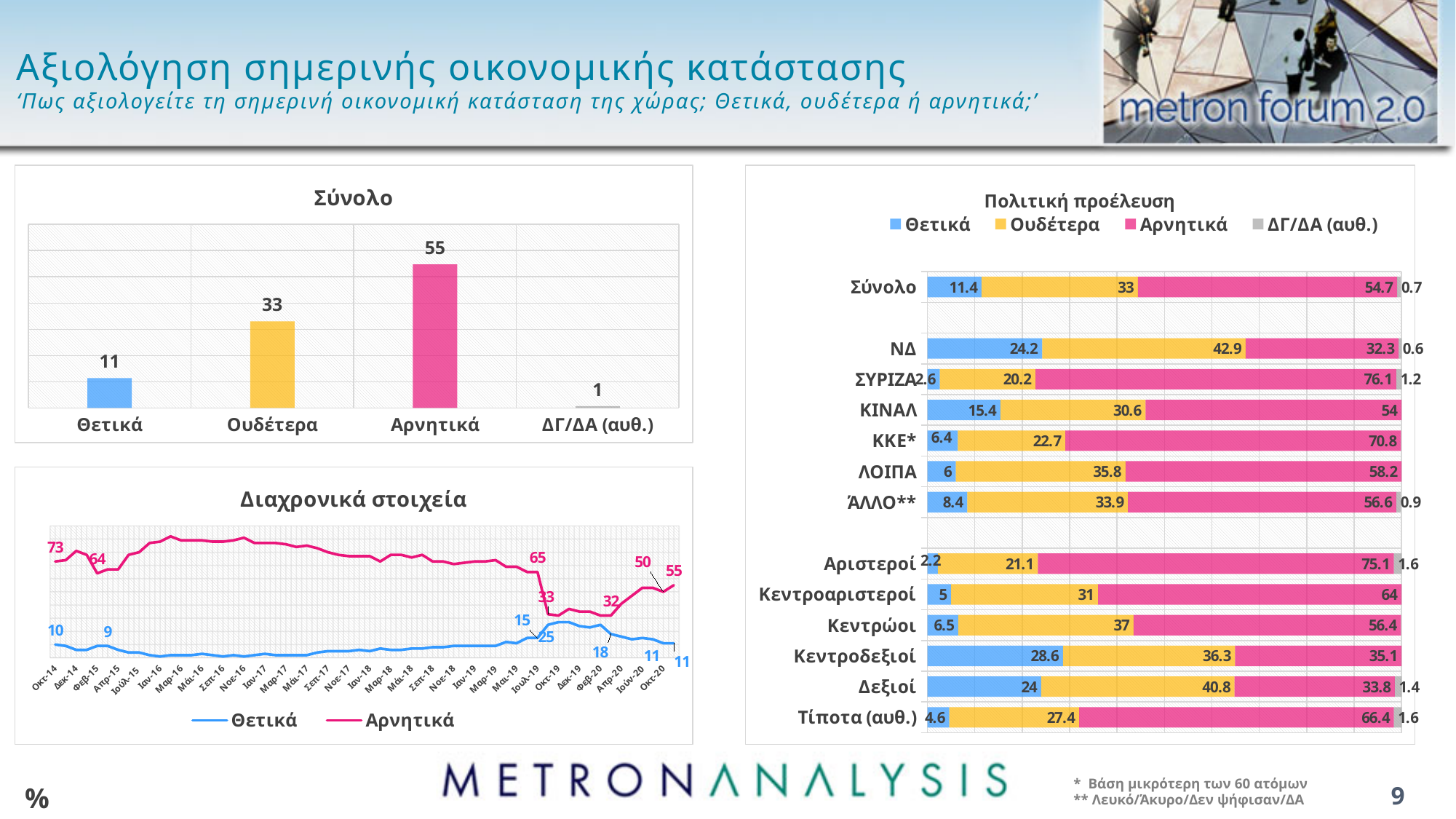
In the 'Σύνολο' chart, how many categories are shown? 4 In the 'Διαχρονικά στοιχεία' chart, what is the value of Αρνητικά at Οκτ-14? 73 In the 'Διαχρονικά στοιχεία' chart, which series is higher at Οκτ-20, Θετικά or Αρνητικά? Αρνητικά What kind of chart is 'Διαχρονικά στοιχεία'? line chart In the 'Σύνολο' chart, what is the difference between Αρνητικά and Ουδέτερα? 22 In the 'Σύνολο' chart, what is the value for Αρνητικά? 55 In the 'Πολιτική προέλευση' chart, how many series does the legend list? 4 In the 'Πολιτική προέλευση' chart, what is the Αρνητικά value for ΣΥΡΙΖΑ? 76.1 In the 'Σύνολο' chart, which category has the lowest value? ΔΓ/ΔΑ (αυθ.) In the 'Διαχρονικά στοιχεία' chart, how many series does the legend list? 2 In the 'Πολιτική προέλευση' chart, which group has the highest Θετικά value? Κεντροδεξιοί In the 'Πολιτική προέλευση' chart, what is the Ουδέτερα value for ΝΔ? 42.9